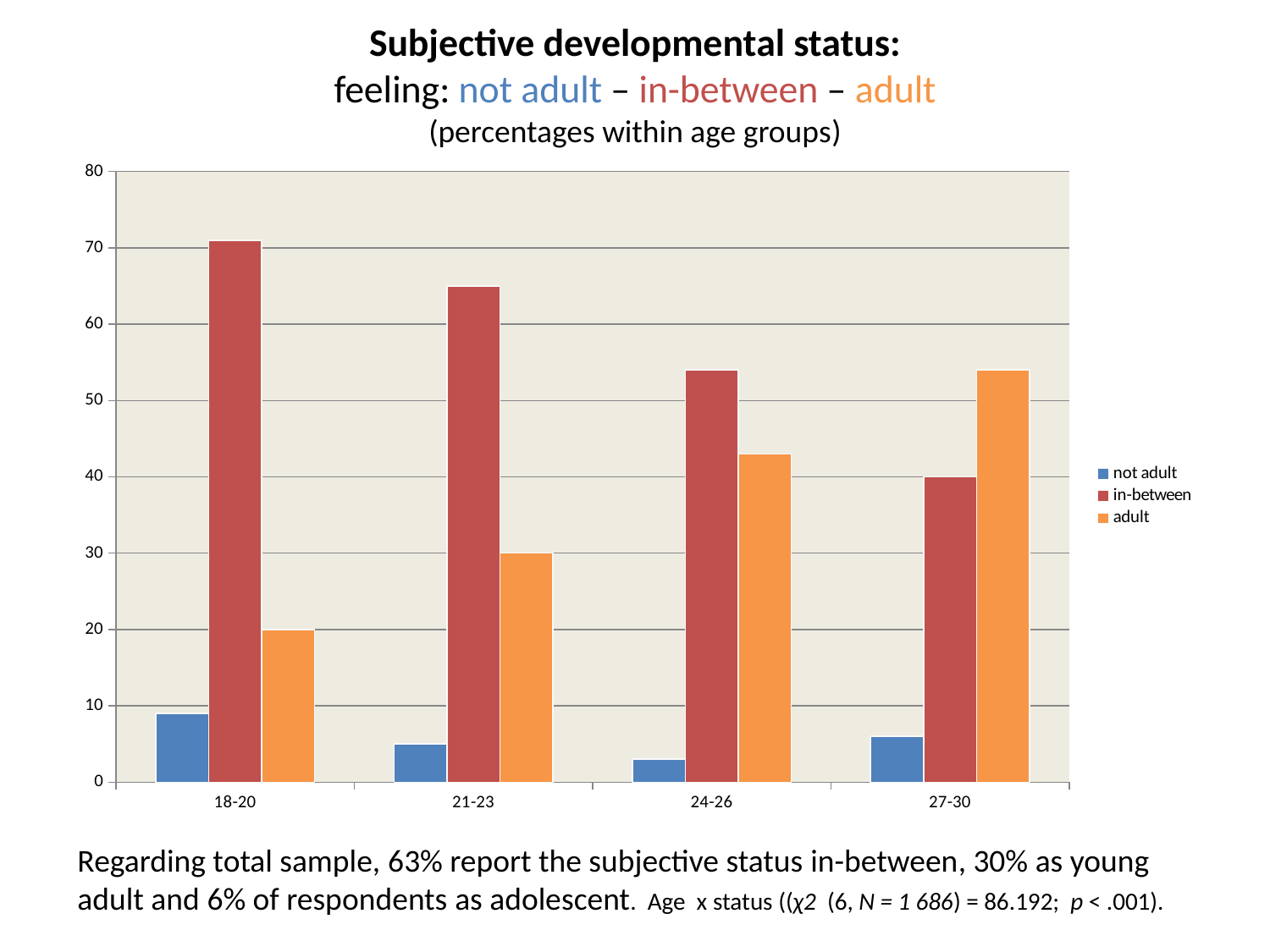
Do the in-between values rise or fall across the age groups from 18-20 to 27-30? fall Is the not adult value for 21-23 greater or less than 10? less How many series does the legend list? 3 Is the adult value for 24-26 greater or less than 40? greater What kind of chart is shown on the slide? bar chart Which age group has the highest in-between value? 18-20 For the 27-30 age group, which is larger: the in-between value or the adult value? adult How many age groups are shown on the x axis? 4 Which age group has the highest adult value? 27-30 Which colour represents the adult series in the legend? orange Which age group has the lowest not adult value? 24-26